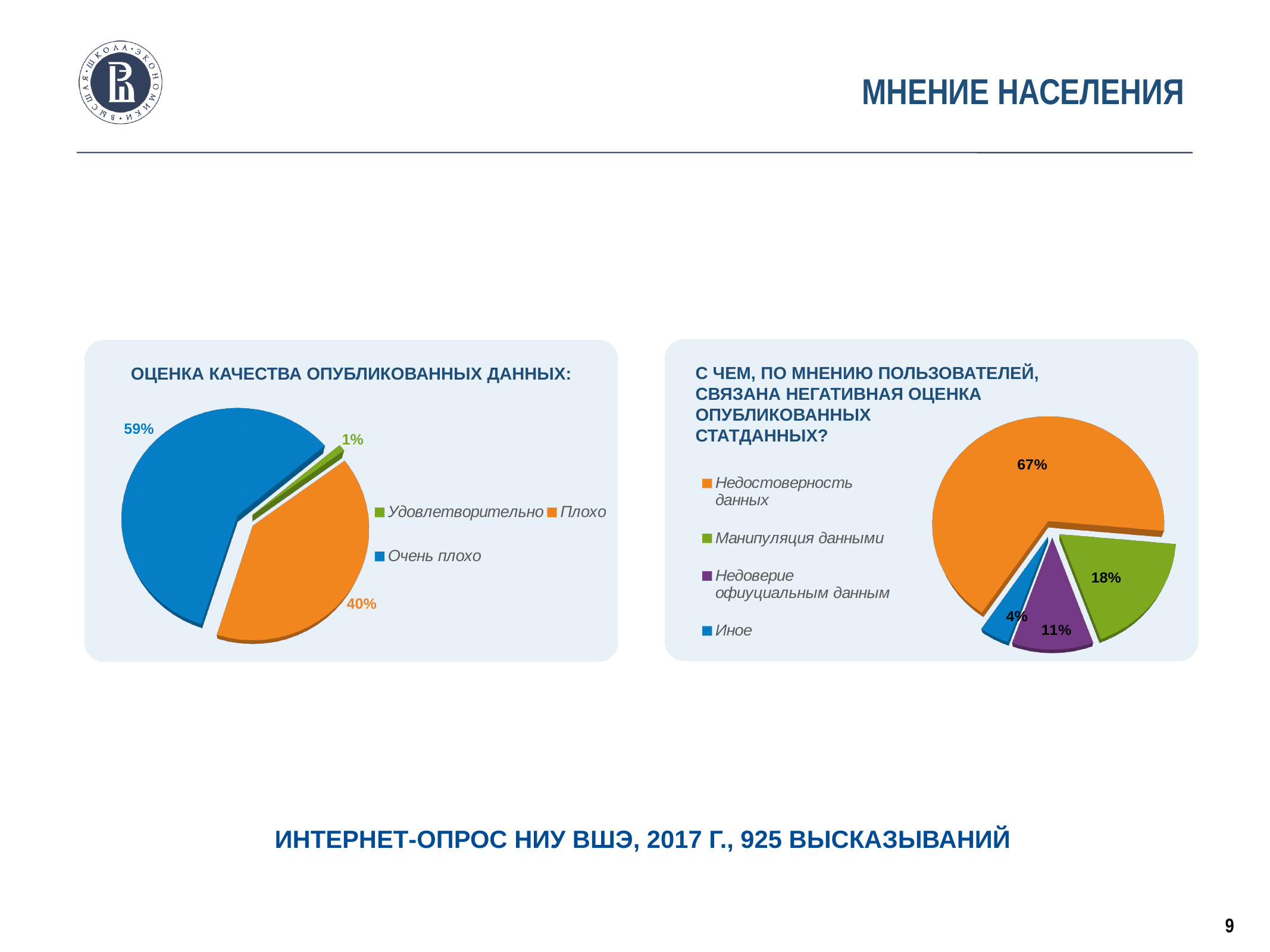
In the right chart about reasons for negative assessment of published statistics, what share is 'Манипуляция данными'? 18% In the left chart 'ОЦЕНКА КАЧЕСТВА ОПУБЛИКОВАННЫХ ДАННЫХ', what is the difference between 'Очень плохо' and 'Плохо'? 19% In the left chart 'ОЦЕНКА КАЧЕСТВА ОПУБЛИКОВАННЫХ ДАННЫХ', what share is 'Очень плохо'? 59% In the left chart 'ОЦЕНКА КАЧЕСТВА ОПУБЛИКОВАННЫХ ДАННЫХ', which category has the largest share? Очень плохо In the right chart about reasons for negative assessment of published statistics, what share is 'Недоверие официальным данным'? 11% In the right chart about reasons for negative assessment of published statistics, which is larger: 'Манипуляция данными' or 'Недоверие официальным данным'? Манипуляция данными In the right chart about reasons for negative assessment of published statistics, how many categories does the legend list? 4 In the left chart 'ОЦЕНКА КАЧЕСТВА ОПУБЛИКОВАННЫХ ДАННЫХ', what share is 'Удовлетворительно'? 1% In the right chart about reasons for negative assessment of published statistics, what share is 'Недостоверность данных'? 67% In the right chart about reasons for negative assessment of published statistics, which category has the smallest share? Иное What type of chart is the left chart 'ОЦЕНКА КАЧЕСТВА ОПУБЛИКОВАННЫХ ДАННЫХ'? Pie chart In the left chart 'ОЦЕНКА КАЧЕСТВА ОПУБЛИКОВАННЫХ ДАННЫХ', what share is 'Плохо'? 40%